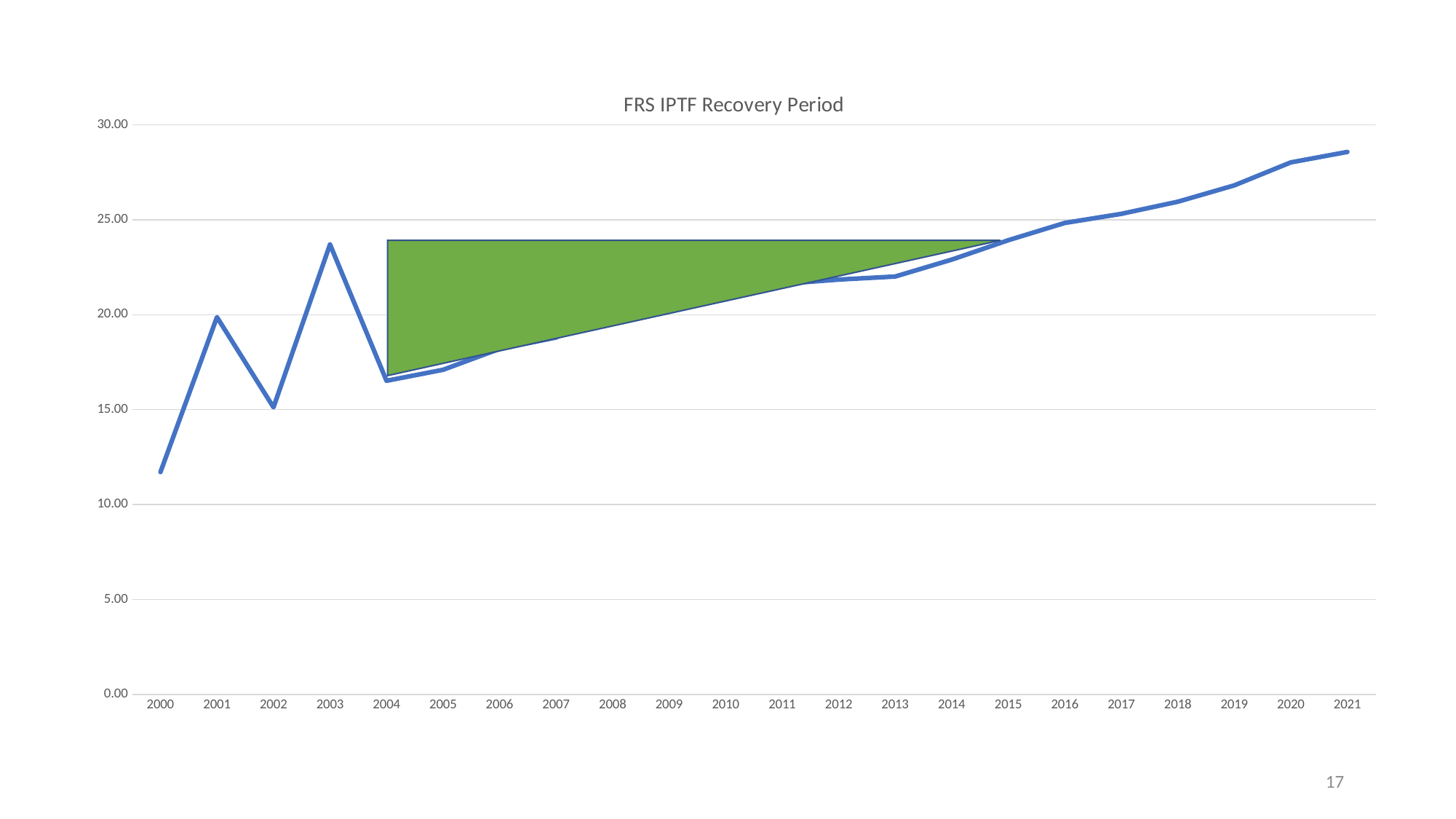
What is the title of the chart? FRS IPTF Recovery Period Is the value for 2000 greater or less than 15.00? less Which year has the larger value, 2002 or 2003? 2003 What colour is the shaded triangle overlaid on the chart? green Which year has the highest value? 2021 What kind of chart is shown on the slide? line chart How many years are plotted along the x axis? 22 Is the value for 2003 greater or less than 20.00? greater Do the values generally rise or fall from 2004 to 2021? rise Which year has the lowest value? 2000 Is the value for 2021 greater or less than 25.00? greater